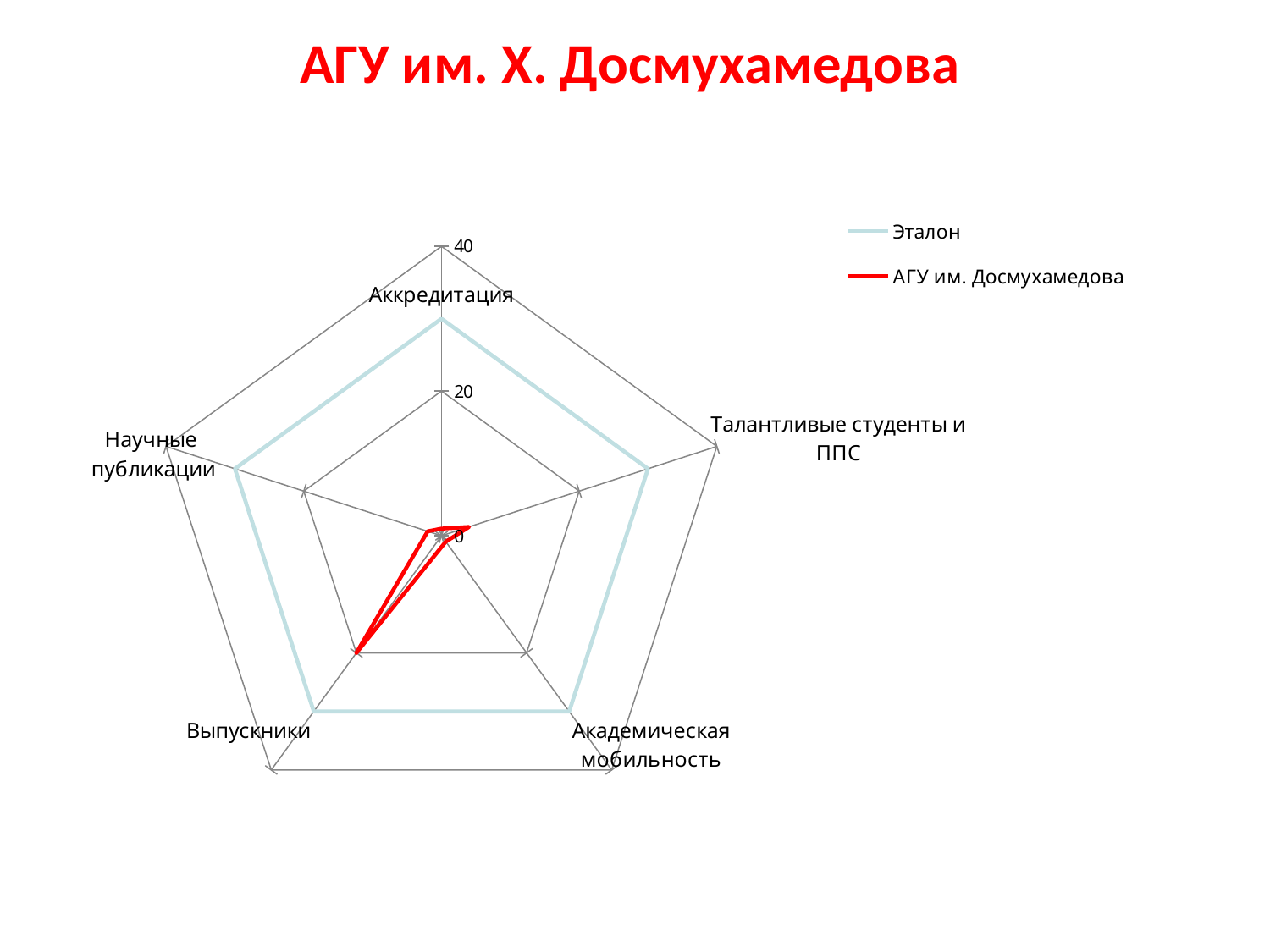
How many categories (axes) does the radar chart have? 5 For Аккредитация, which series has the larger value, Эталон or АГУ им. Досмухамедова? Эталон For АГУ им. Досмухамедова, which is larger: the value for Выпускники or the value for Академическая мобильность? Выпускники How many series does the legend list? 2 Is the Эталон value for Научные публикации greater or less than 40? less Is the АГУ им. Досмухамедова value for Выпускники greater or less than 40? less Is the АГУ им. Досмухамедова value for Аккредитация greater or less than 20? less What colour is the line for АГУ им. Досмухамедова? Red What kind of chart is shown on the slide? Radar chart What are the two series named in the legend? Эталон and АГУ им. Досмухамедова On which axis does the АГУ им. Досмухамедова series reach its highest value? Выпускники